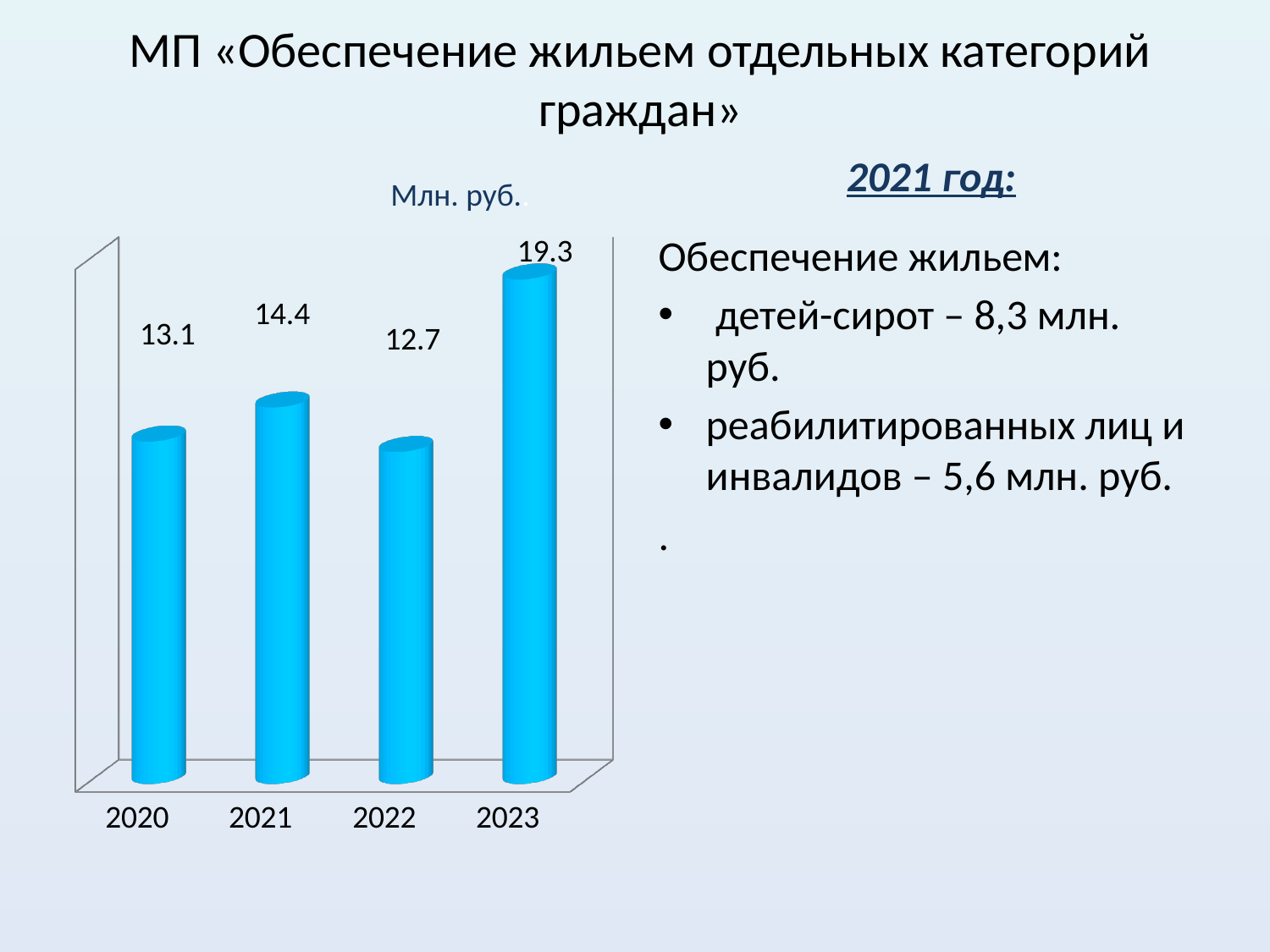
What is the value for 2022? 12.7 What is the value for 2020? 13.1 What is the difference between the values for 2023 and 2022? 6.6 How many years are shown on the chart? 4 What is the difference between the values for 2021 and 2020? 1.3 Which year has the highest value? 2023 What is the value for 2023? 19.3 What kind of chart is shown on the slide? bar chart Which is larger, the value for 2021 or the value for 2022? 2021 Which year has the lowest value? 2022 What unit is indicated above the chart? Млн. руб. What is the value for 2021? 14.4